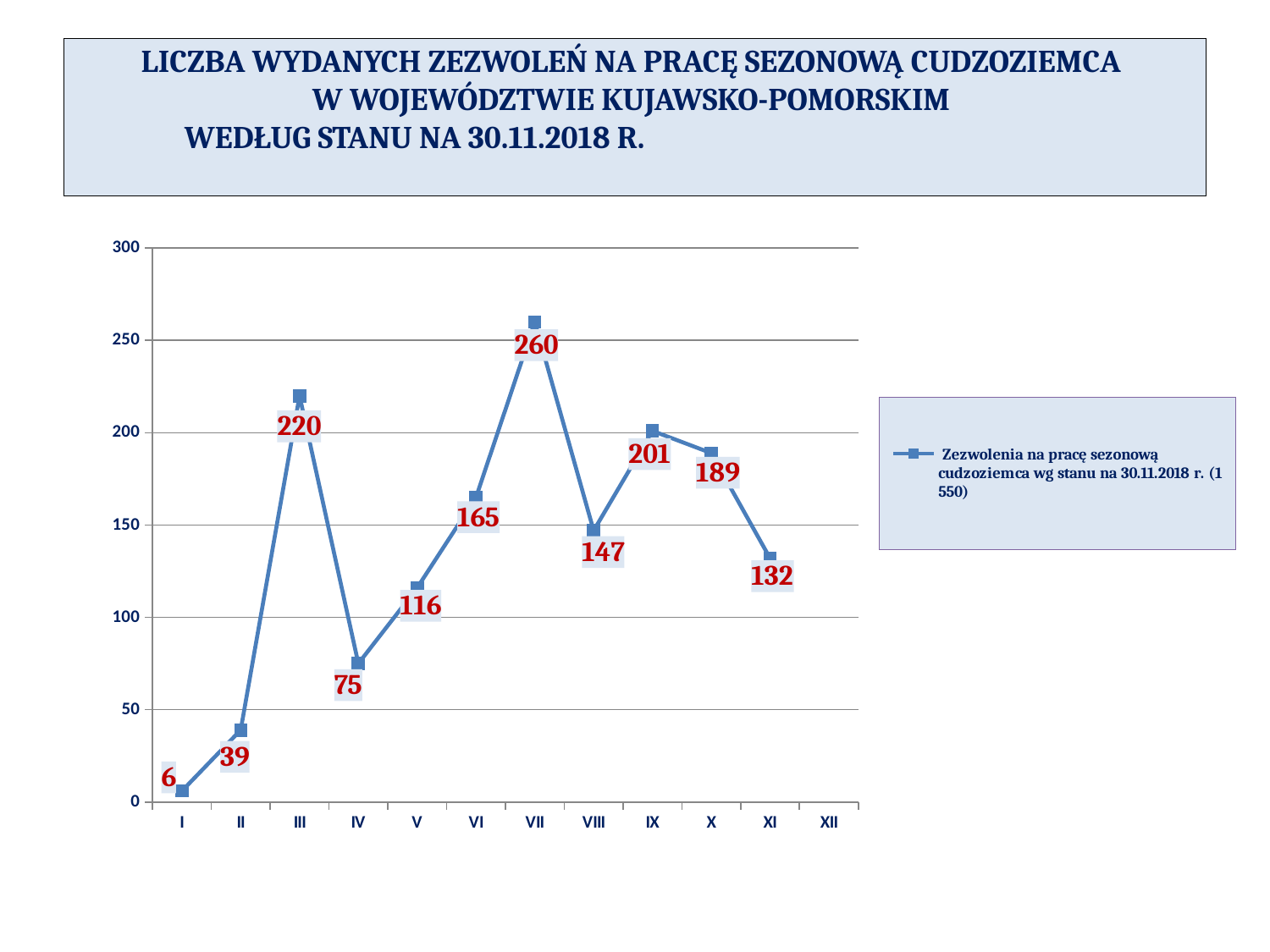
Do the values rise or fall from month IX to month XI? fall What is the value for month VII? 260 What kind of chart is shown? line chart What is the value for month IV? 75 Is the value for month VI greater or less than 150? greater Which is larger, the value for month IX or the value for month X? IX How many months have a plotted data point? 11 What is the value for month XI? 132 What is the difference between the values for month VII and month III? 40 Which month has the highest value? VII Which month has the lowest plotted value? I How many series does the legend list? 1